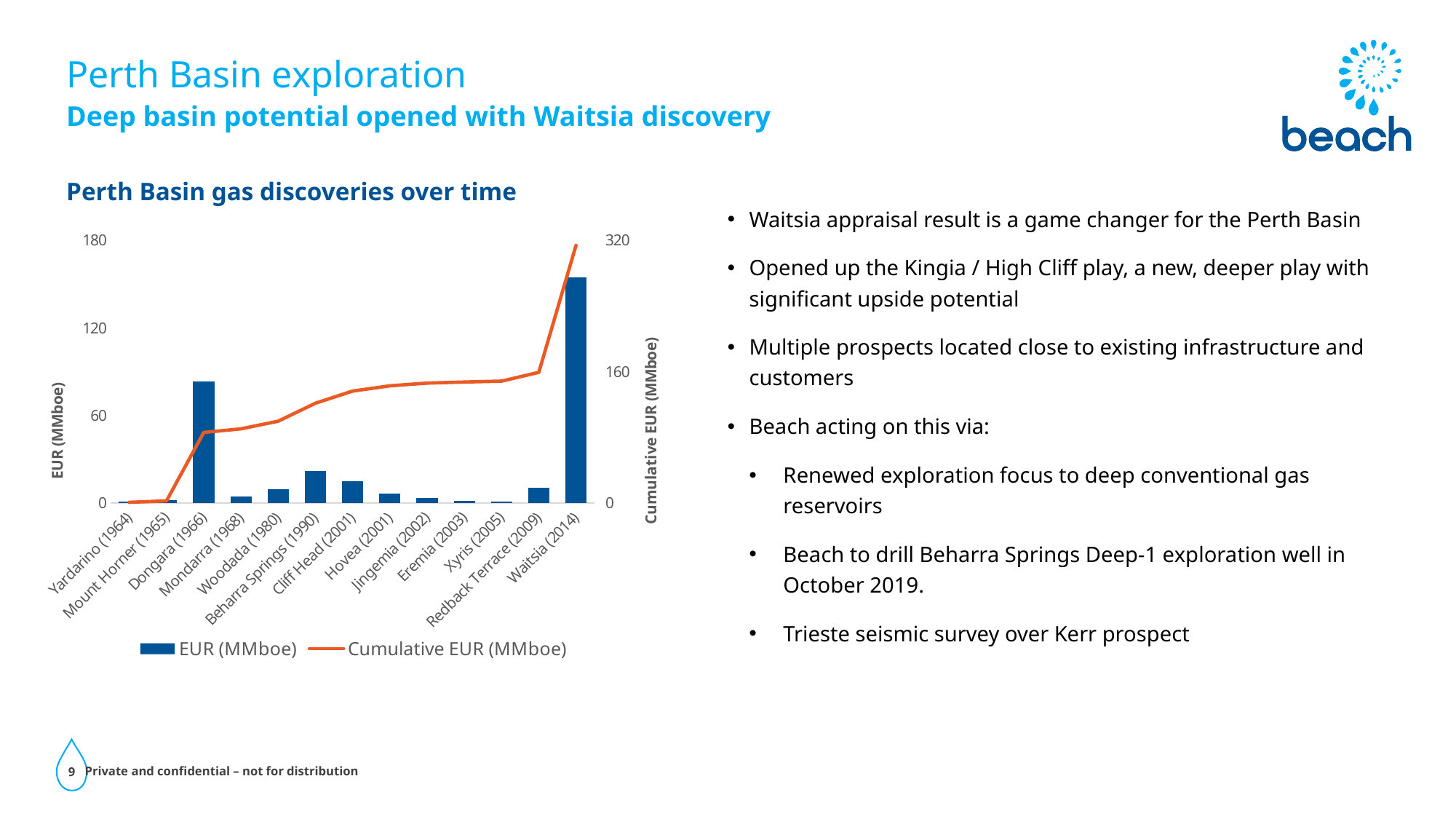
Is the Cumulative EUR (MMboe) value at Dongara (1966) greater or less than 160? less How many discoveries (categories) are shown on the x axis of the chart? 13 Does the Cumulative EUR (MMboe) line rise or fall from Yardarino (1964) to Waitsia (2014)? rise What is the label of the right-hand vertical axis of the chart? Cumulative EUR (MMboe) Is the EUR (MMboe) value for Dongara (1966) greater or less than 60? greater Is the Cumulative EUR (MMboe) value at Waitsia (2014) greater or less than 160? greater Which discovery has the highest EUR (MMboe) bar in the chart? Waitsia (2014) What is the title of the chart? Perth Basin gas discoveries over time Which has a larger EUR (MMboe) bar, Dongara (1966) or Cliff Head (2001)? Dongara (1966) How many series does the chart legend list? 2